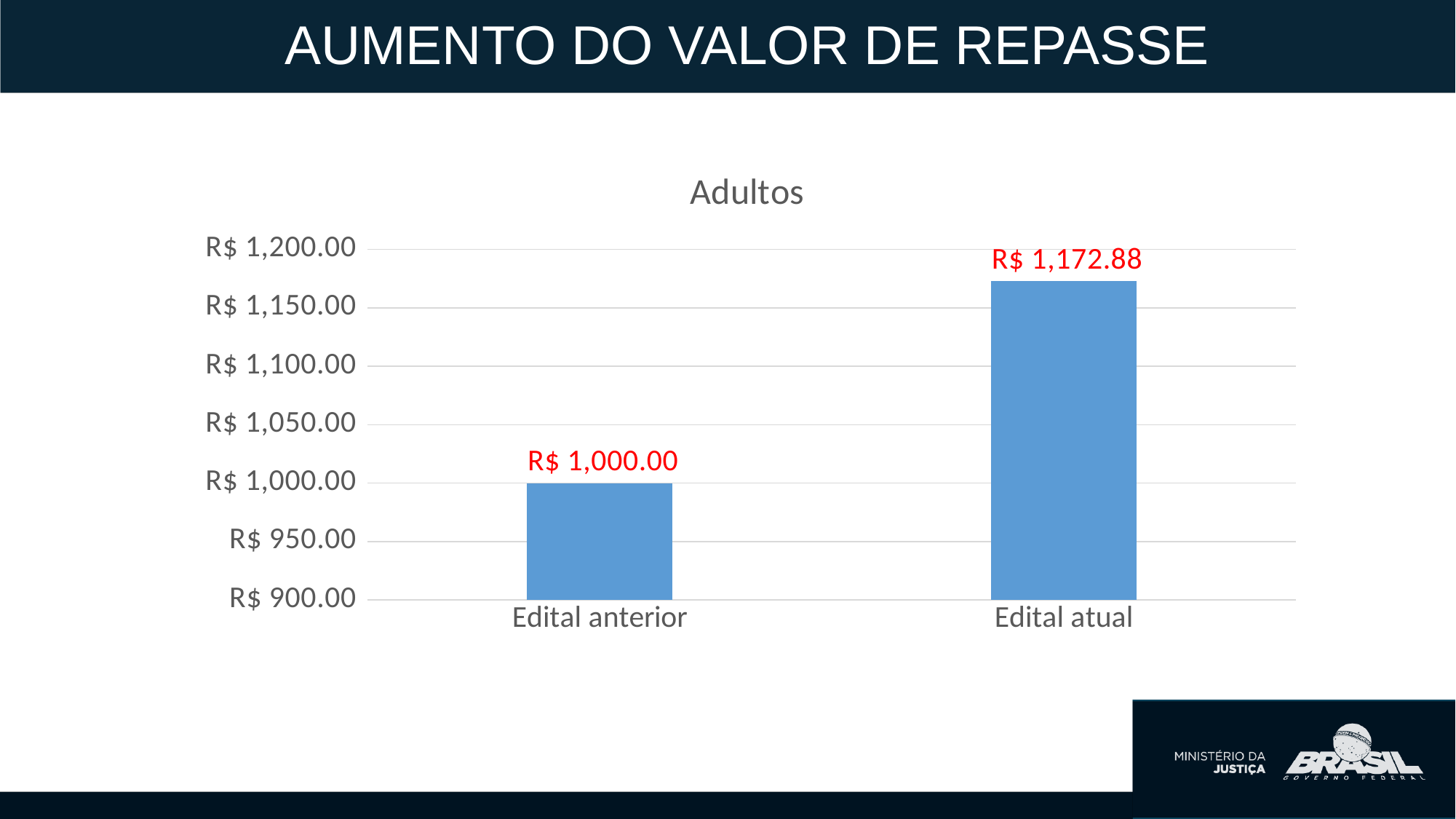
What is the difference between the values for Edital atual and Edital anterior? R$ 172.88 Which category has the highest value? Edital atual What is the title of the chart? Adultos What colour are the bars in the chart? blue How many categories are shown on the x axis? 2 Which is larger, the value for Edital anterior or Edital atual? Edital atual What is the value for Edital atual? R$ 1,172.88 Is the value for Edital atual greater or less than R$ 1,150.00? greater What is the value for Edital anterior? R$ 1,000.00 What kind of chart is shown on the slide? bar chart Which category has the lowest value? Edital anterior Do the values rise or fall from Edital anterior to Edital atual? rise